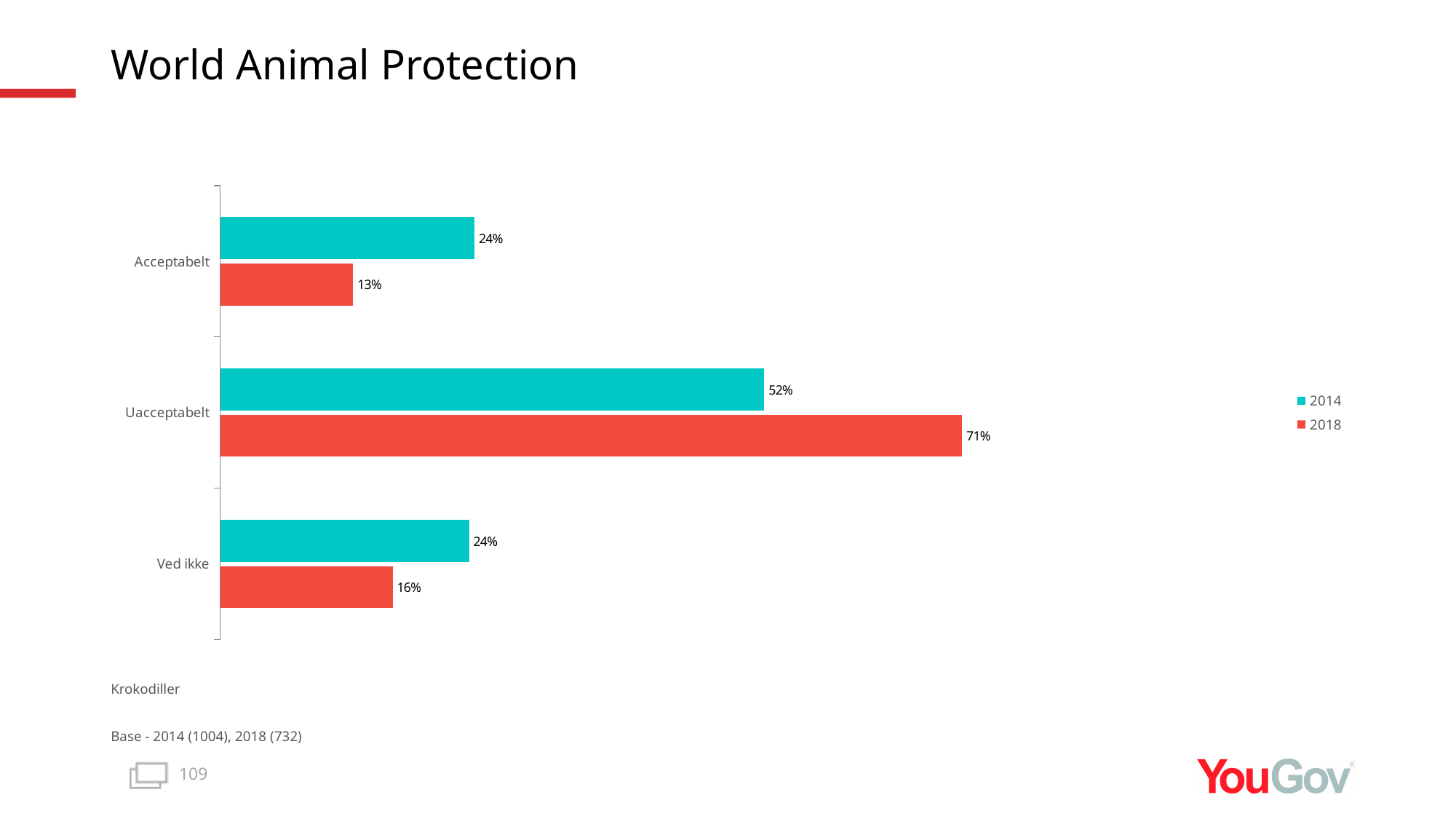
What is the difference between the 2014 and 2018 values for Acceptabelt? 11 percentage points What is the 2018 value for Ved ikke? 16% Which category has the lowest 2018 value? Acceptabelt What kind of chart is shown on the slide? Bar chart What is the 2018 value for Acceptabelt? 13% Which colour represents the 2018 series? Red What is the difference between the 2018 and 2014 values for Uacceptabelt? 19 percentage points How many series does the legend list? 2 How many categories are shown on the chart? 3 Which category has the highest 2018 value? Uacceptabelt What is the 2014 value for Uacceptabelt? 52% Which is larger for Ved ikke, the 2014 value or the 2018 value? 2014